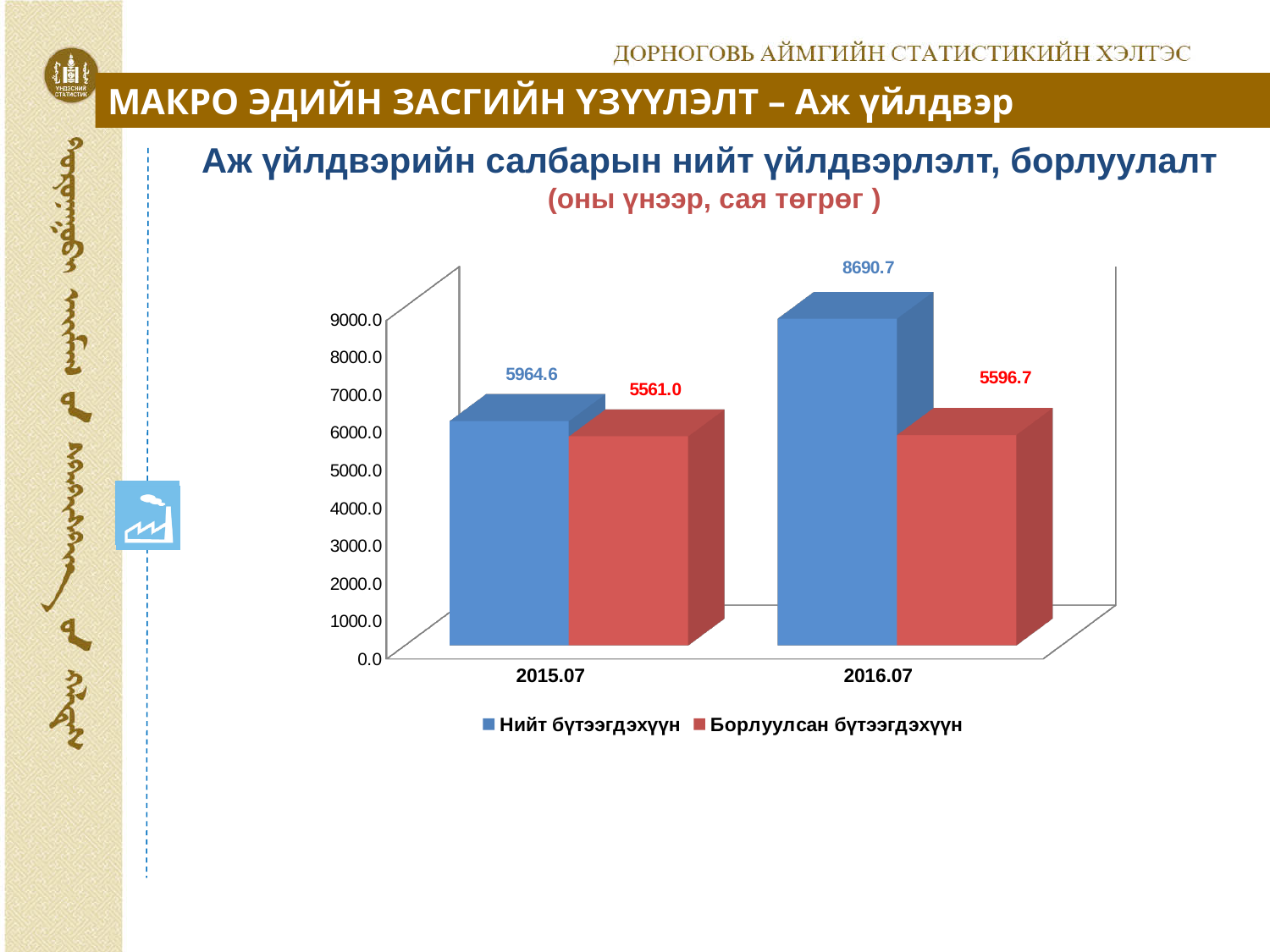
What is the value of Борлуулсан бүтээгдэхүүн for 2016.07? 5596.7 How many categories are shown on the x axis? 2 What is the value of Нийт бүтээгдэхүүн for 2015.07? 5964.6 Which category has the highest value for Нийт бүтээгдэхүүн? 2016.07 What kind of chart is shown on the slide? bar chart What is the difference between Нийт бүтээгдэхүүн and Борлуулсан бүтээгдэхүүн in 2016.07? 3094.0 What is the value of Борлуулсан бүтээгдэхүүн for 2015.07? 5561.0 Is the value of Нийт бүтээгдэхүүн for 2016.07 greater or less than 8000.0? greater What is the difference between Нийт бүтээгдэхүүн in 2016.07 and 2015.07? 2726.1 How many series does the legend list? 2 Which is larger in 2015.07: Нийт бүтээгдэхүүн or Борлуулсан бүтээгдэхүүн? Нийт бүтээгдэхүүн What is the value of Нийт бүтээгдэхүүн for 2016.07? 8690.7